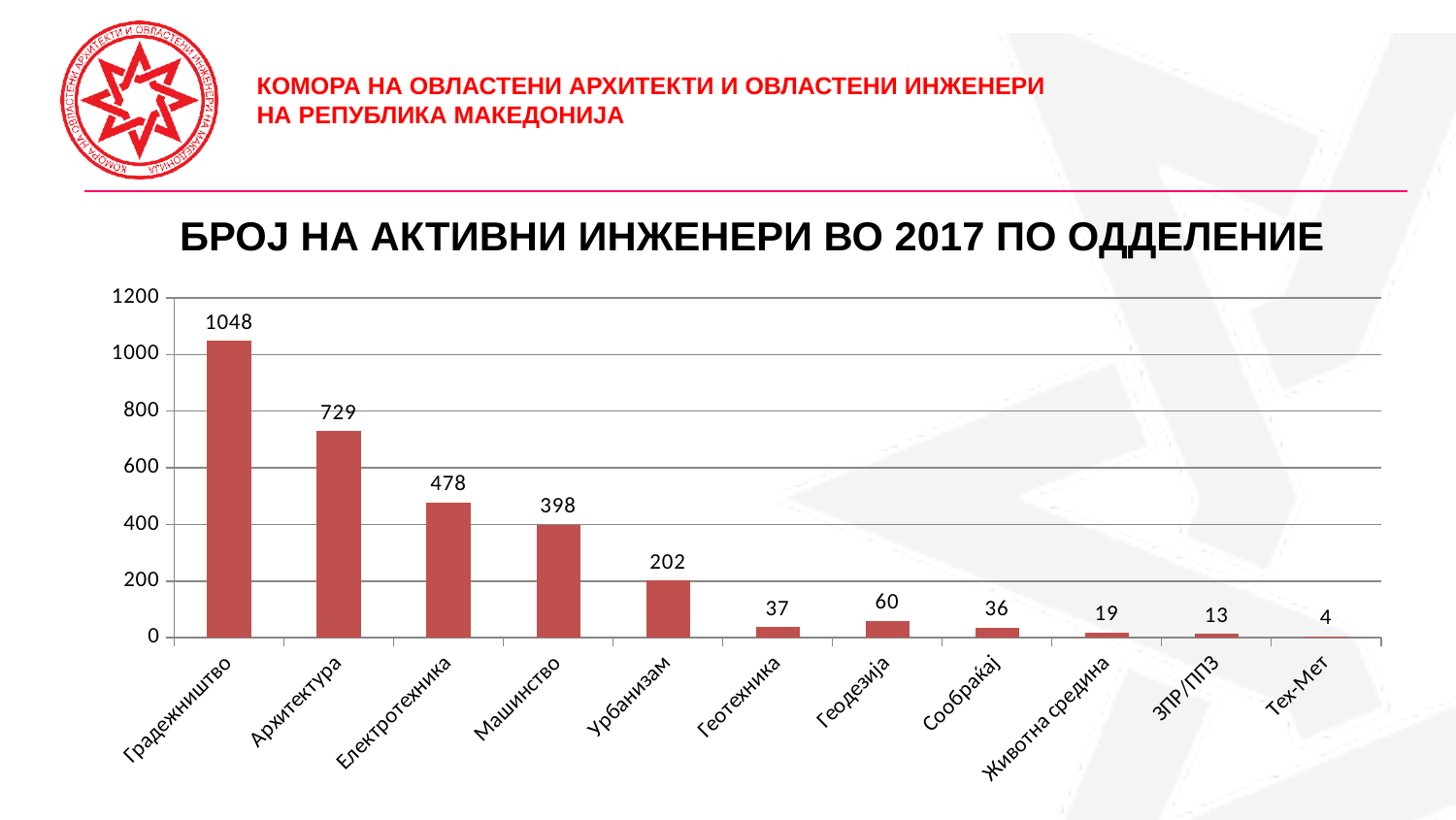
What is the difference between the values for Архитектура and Електротехника? 251 What kind of chart is shown on the slide? bar chart What is the value for Животна средина? 19 Which category has the lowest value? Тех-Мет Which is larger, the value for Геотехника or the value for Сообраќај? Геотехника Is the value for Машинство greater or less than 400? less What is the value for Геодезија? 60 What is the value for Градежништво? 1048 Do the values generally rise or fall from left to right along the x axis? fall Which category has the highest value? Градежништво How many categories are shown on the x axis? 11 What is the title of the chart? БРОЈ НА АКТИВНИ ИНЖЕНЕРИ ВО 2017 ПО ОДДЕЛЕНИЕ